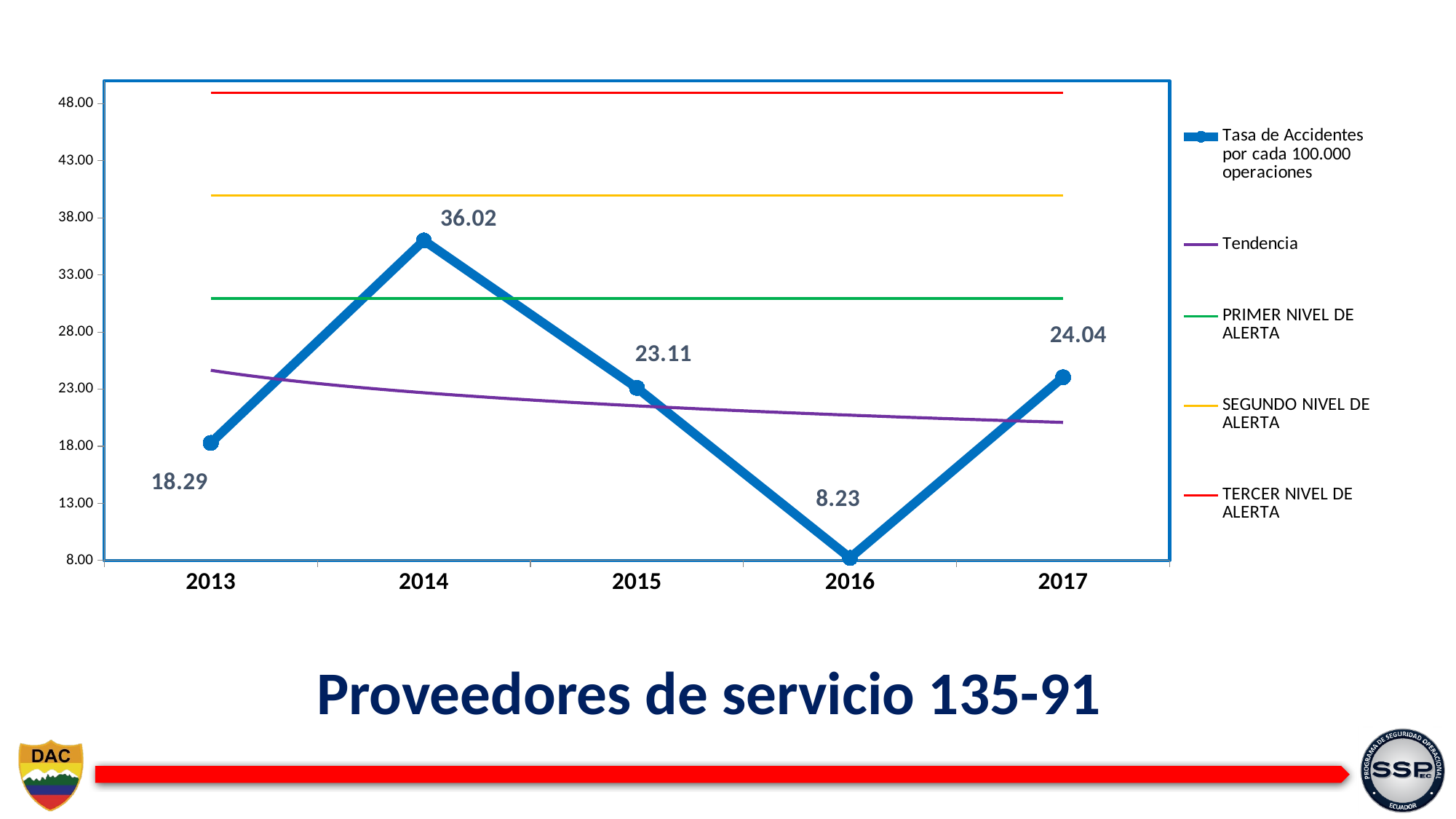
What kind of chart is shown on the slide? Line chart Is the PRIMER NIVEL DE ALERTA line greater or less than 28.00? greater How many years are plotted on the x axis? 5 What is the accident rate value shown for 2016? 8.23 What is the difference between the accident rate in 2014 and in 2013? 17.73 Which year has the highest accident rate? 2014 Which year has a higher accident rate, 2015 or 2017? 2017 Which year has the lowest accident rate? 2016 Does the Tendencia line rise or fall from 2013 to 2017? Fall What is the accident rate (Tasa de Accidentes por cada 100.000 operaciones) for 2014? 36.02 What is the accident rate value shown for 2017? 24.04 How many series does the legend list? 5